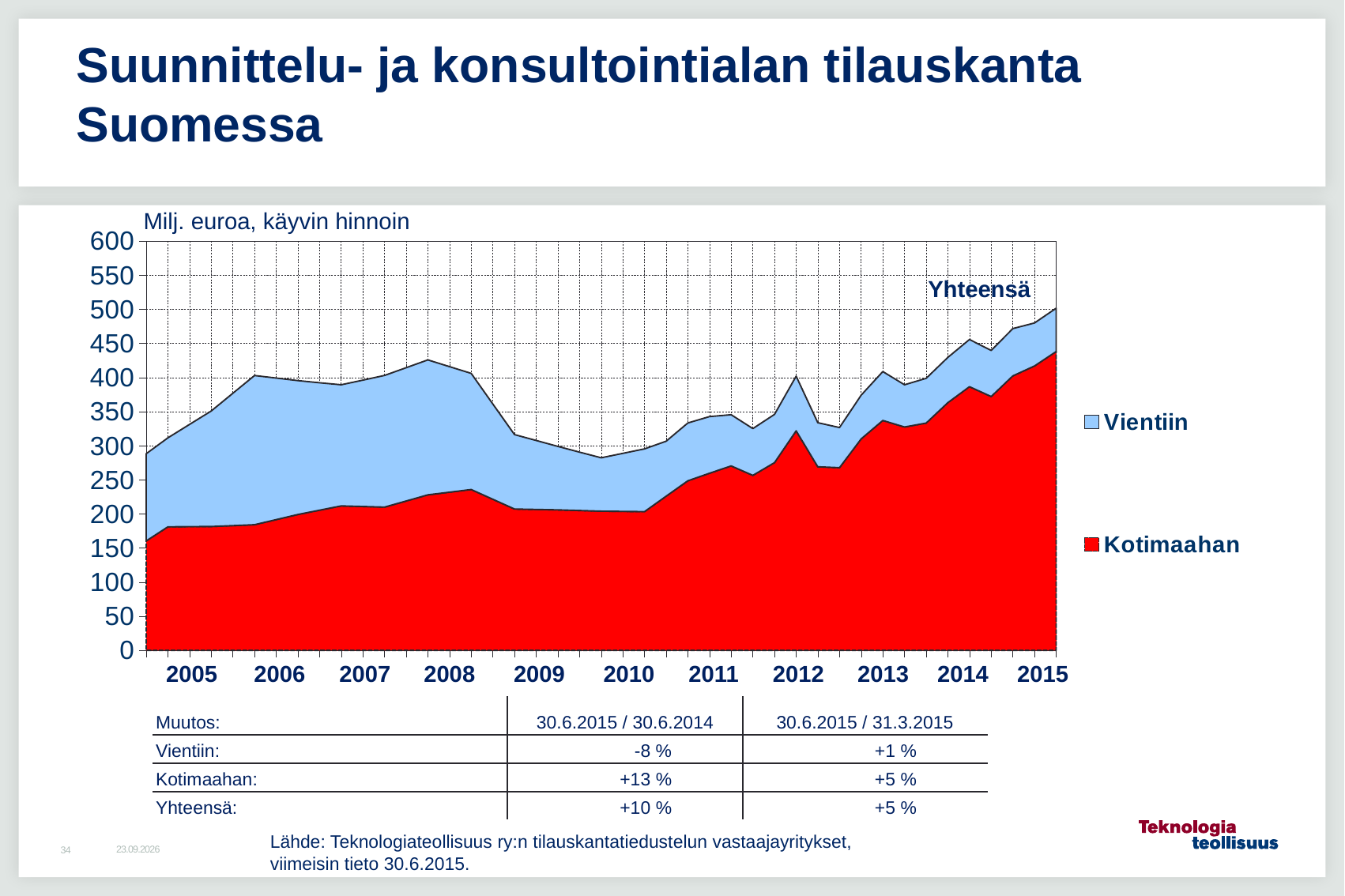
Does the Kotimaahan series rise or fall from 2010 to 2015? rise Is the Kotimaahan value at the start of 2005 greater or less than 200? less In 2015, which series has the larger value, Vientiin or Kotimaahan? Kotimaahan How many years are labelled on the chart's x axis? 11 Which two series are listed in the chart legend? Vientiin and Kotimaahan Is the total (Yhteensä) value at the end of 2015 greater or less than 450? greater Is the Kotimaahan value at the end of 2015 greater or less than 400? greater What kind of chart is shown on the slide? Stacked area chart What unit is stated above the chart's y axis? Milj. euroa, käyvin hinnoin How many series does the chart legend list? 2 According to the table below the chart, what is the change (Muutos) for Kotimaahan for 30.6.2015 / 30.6.2014? +13 %